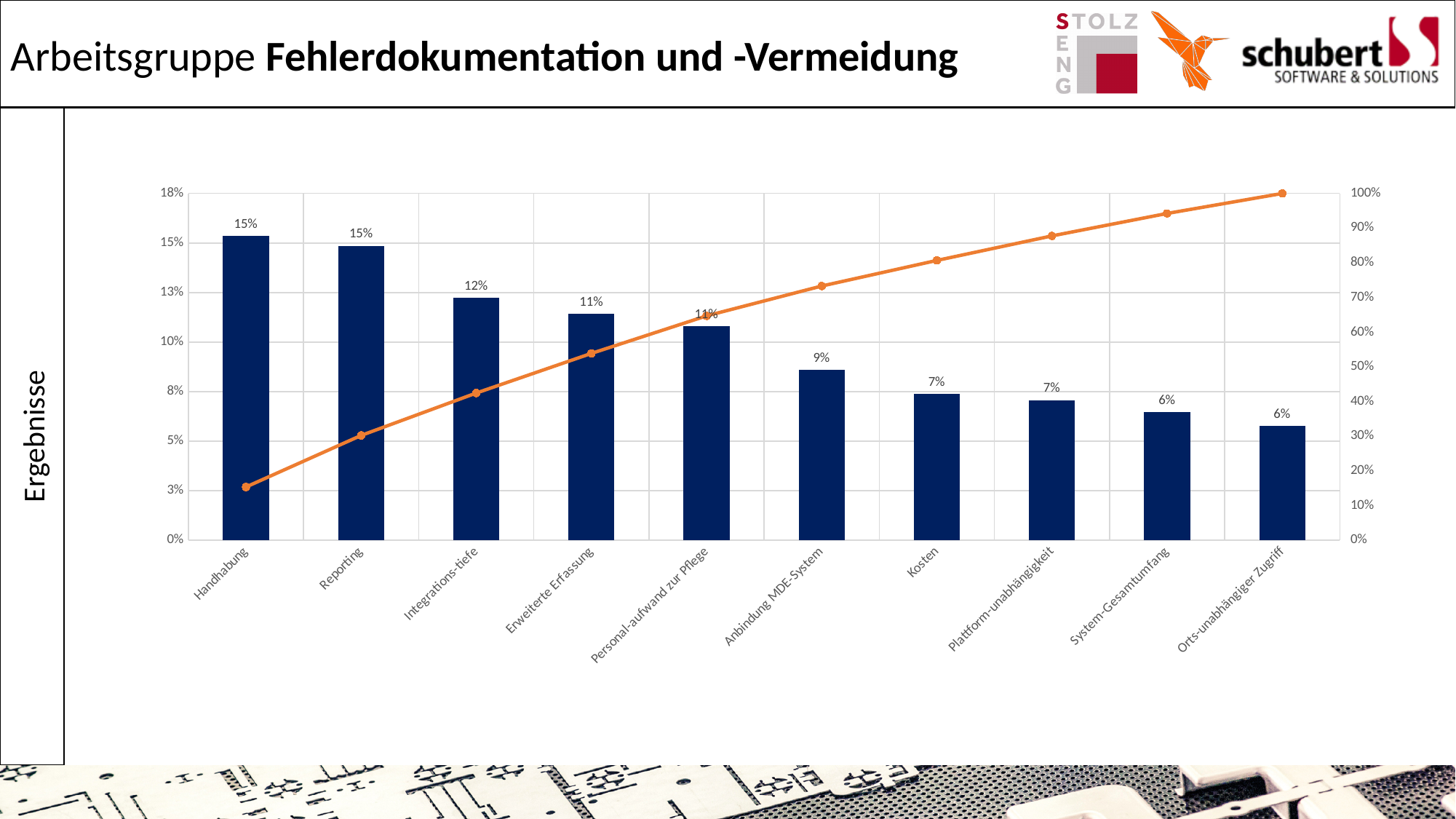
Is the cumulative line value at Handhabung greater or less than 20% on the right axis? less What kind of chart is shown on the slide? bar chart with a cumulative line How many categories are shown on the x axis? 10 What is the value of the bar for Anbindung MDE-System? 9% What is the value of the bar for Handhabung? 15% What is the difference between the bar values for Integrations-tiefe and Kosten? 5% What is the value of the bar for Orts-unabhängiger Zugriff? 6% Which bar is larger, Integrations-tiefe or Kosten? Integrations-tiefe Do the bar values rise or fall from left to right along the x axis? fall What is the difference between the bar values for Handhabung and Anbindung MDE-System? 6% What is the value of the bar for Integrations-tiefe? 12%